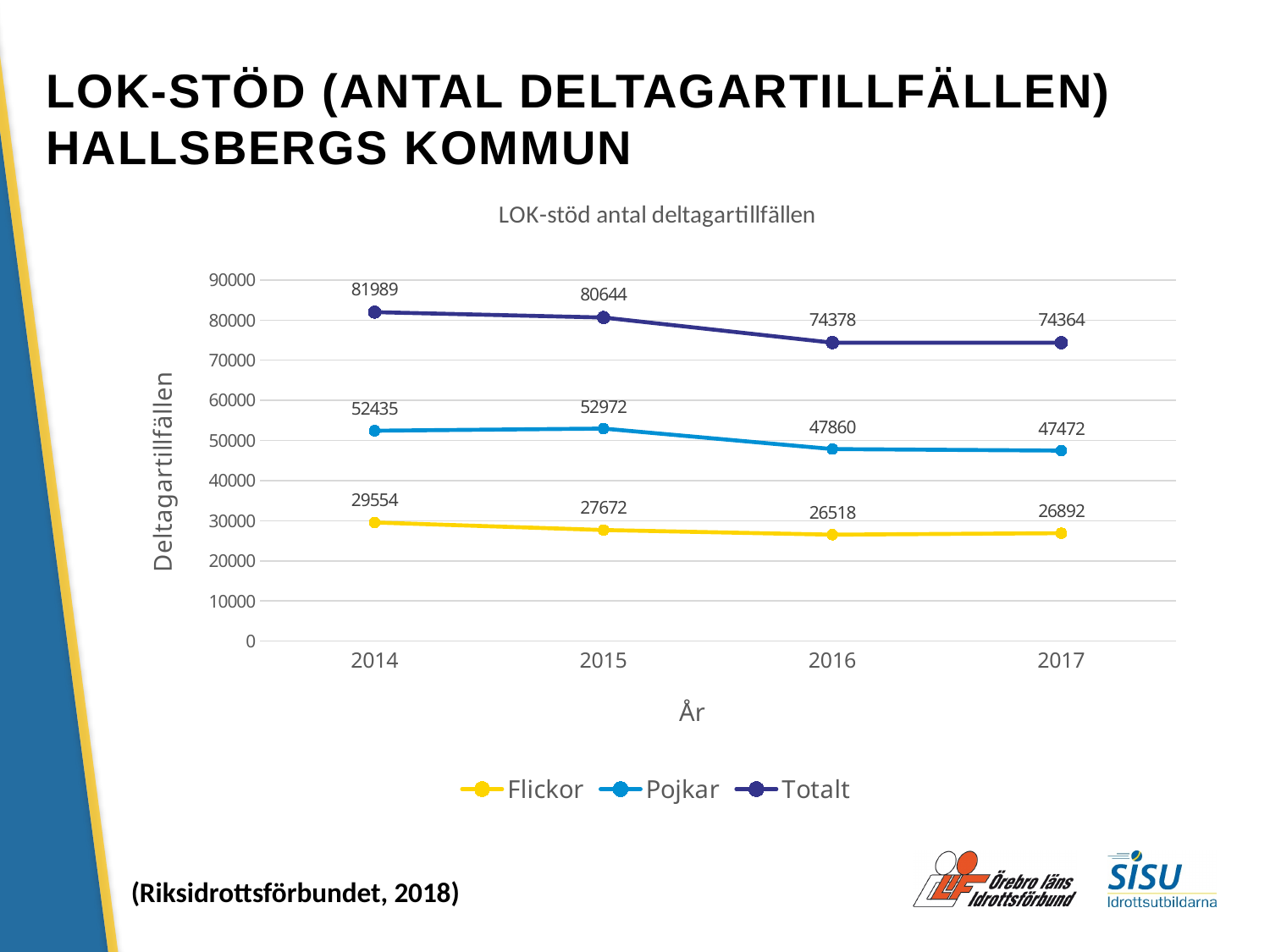
What is the value for Pojkar in 2016? 47860 What is the value for Flickor in 2017? 26892 What is the value for Totalt in 2014? 81989 In which year is the Flickor series highest? 2014 How many series does the legend list? 3 How many years are shown on the x axis? 4 What kind of chart is shown? line chart Does the Totalt series rise or fall from 2014 to 2017? fall Which is larger, the Flickor value in 2015 or in 2016? 2015 Is the value for Pojkar in 2014 greater or less than 50000? greater In which year is the Totalt series lowest? 2017 What is the difference between the Pojkar values in 2015 and 2016? 5112